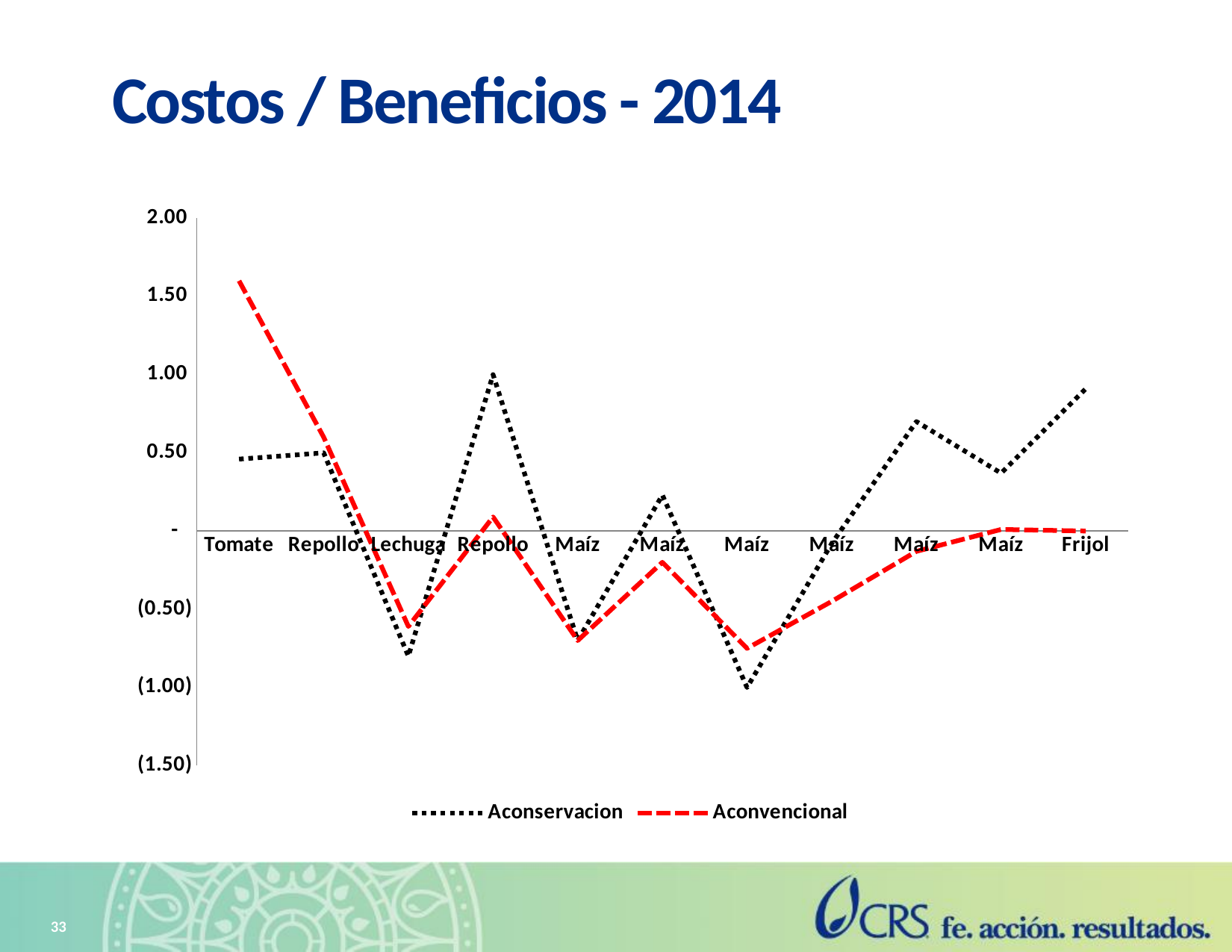
Is the value of Aconvencional at Tomate greater or less than 1.00? greater At Frijol, which series has the larger value, Aconservacion or Aconvencional? Aconservacion How many series does the legend list? 2 Does the Aconvencional series rise or fall from Tomate to Lechuga? fall At which category does the Aconvencional series reach its highest value? Tomate What is the title of the slide containing the chart? Costos / Beneficios - 2014 What kind of chart is shown on the slide? line chart Which series is drawn with the red dashed line? Aconvencional Is the value of Aconvencional at Frijol greater or less than 0.50? less At Tomate, which series has the larger value, Aconservacion or Aconvencional? Aconvencional Is the value of Aconservacion at Frijol greater or less than 0.50? greater How many categories are shown along the x axis? 11